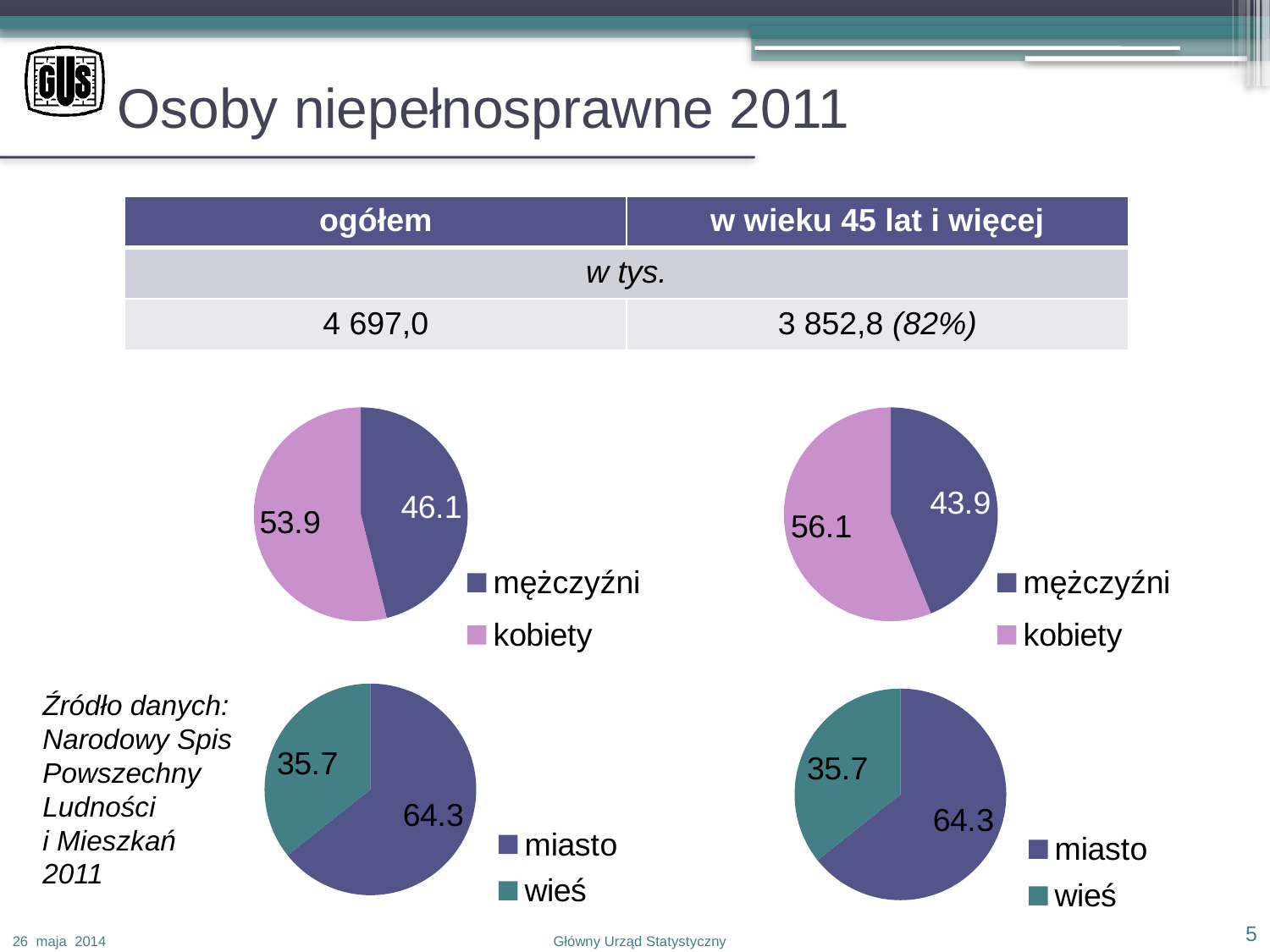
In the top-right pie chart, what is the value for kobiety? 56.1 In the top-right pie chart, what is the difference between the kobiety and mężczyźni values? 12.2 In the top-left pie chart, what is the value for mężczyźni? 46.1 In the top-right pie chart, what is the value for mężczyźni? 43.9 In the bottom-left pie chart, what is the value for miasto? 64.3 In the top-left pie chart, what is the value for kobiety? 53.9 In the bottom-left pie chart, which category has the largest slice? miasto How many entries does the legend of the bottom-left pie chart list? 2 What type of chart is used in the bottom-right chart? pie chart In the bottom-right pie chart, what is the value for wieś? 35.7 In the top-left pie chart, what is the difference between the kobiety and mężczyźni values? 7.8 In the top-right pie chart, which slice is larger, mężczyźni or kobiety? kobiety